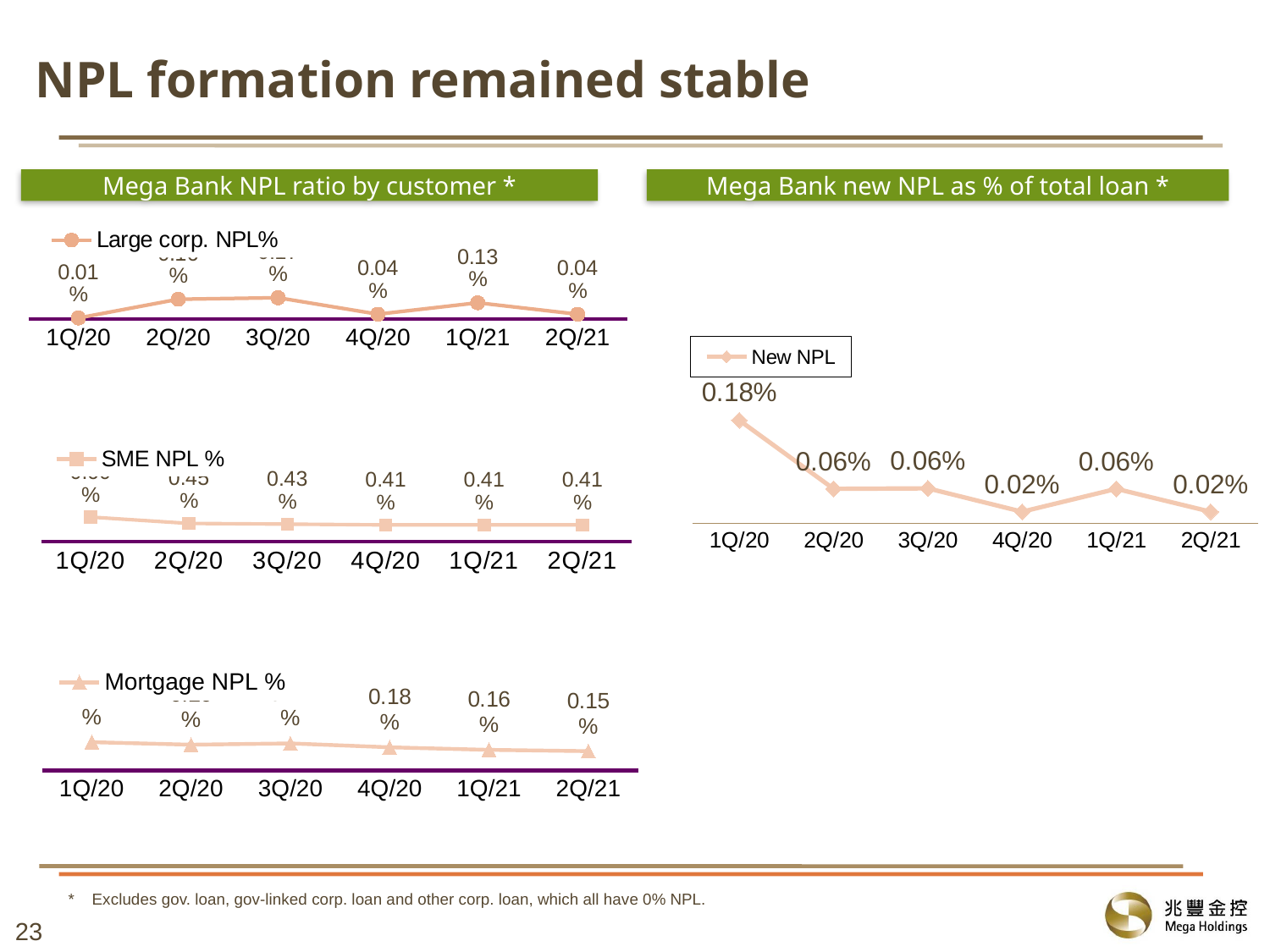
In the Mega Bank NPL ratio by customer chart, what is the Mortgage NPL % for 2Q/21? 0.15% In the Mega Bank new NPL as % of total loan chart, what is the New NPL value for 1Q/20? 0.18% In the Mega Bank NPL ratio by customer chart, what is the SME NPL % for 3Q/20? 0.43% What type of chart is the Mega Bank new NPL as % of total loan chart? line chart In the Mega Bank NPL ratio by customer chart, what is the Large corp. NPL% for 1Q/20? 0.01% In the Mega Bank new NPL as % of total loan chart, is the New NPL value for 1Q/21 larger or smaller than the value for 2Q/21? larger In the Mega Bank NPL ratio by customer chart, does the Mortgage NPL % rise or fall from 4Q/20 to 2Q/21? fall In the Mega Bank new NPL as % of total loan chart, how many quarters are plotted? 6 In the Mega Bank new NPL as % of total loan chart, what is the difference between the New NPL values for 1Q/20 and 2Q/20? 0.12% In the Mega Bank new NPL as % of total loan chart, what is the New NPL value for 4Q/20? 0.02% In the Mega Bank new NPL as % of total loan chart, which quarter has the highest New NPL value? 1Q/20 In the Mega Bank NPL ratio by customer chart, what is the Large corp. NPL% for 1Q/21? 0.13%